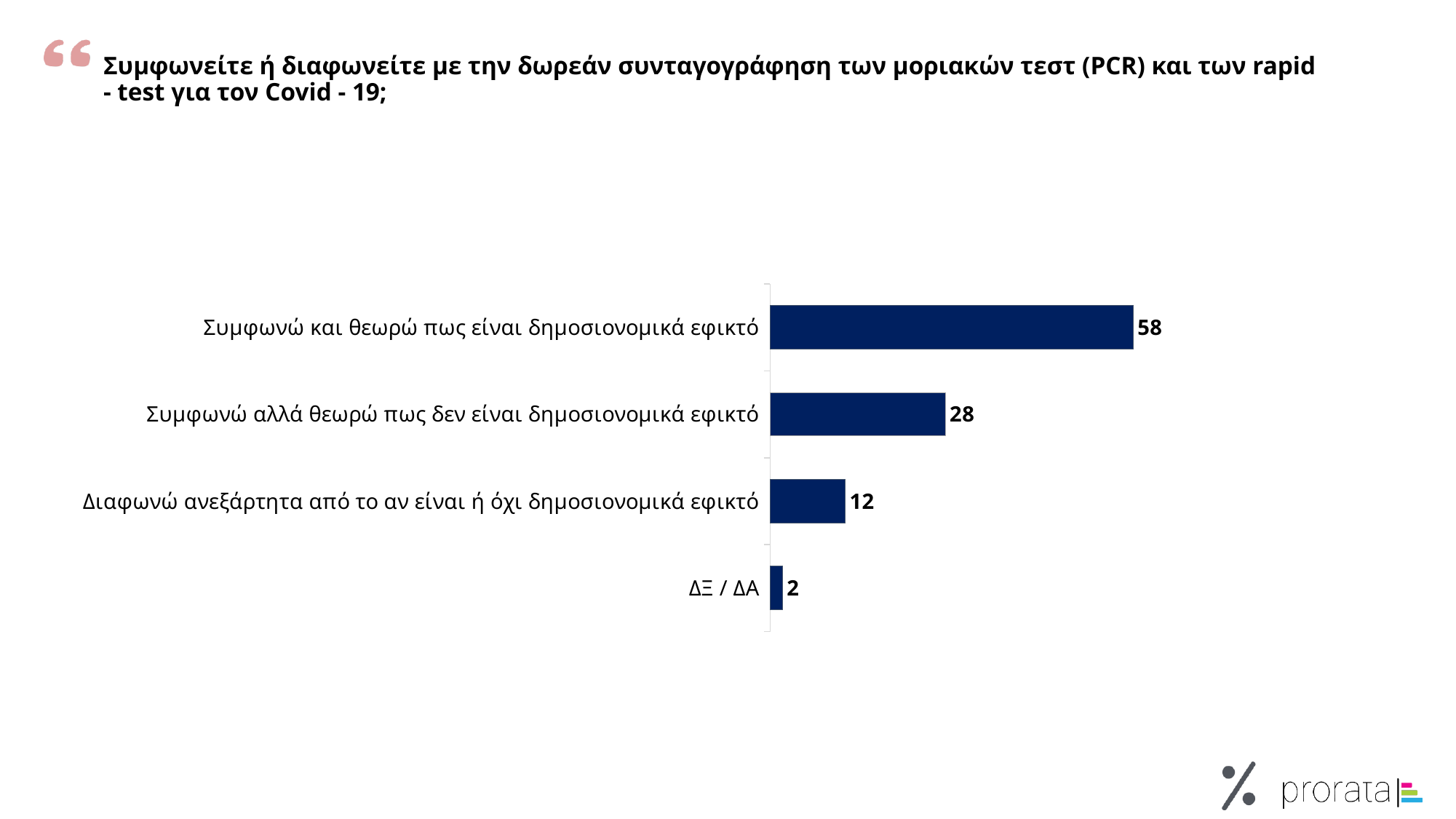
What is the difference between the values for 'Συμφωνώ και θεωρώ πως είναι δημοσιονομικά εφικτό' and 'Συμφωνώ αλλά θεωρώ πως δεν είναι δημοσιονομικά εφικτό'? 30 Which category has the lowest value? ΔΞ / ΔΑ Which is larger: the value for 'Συμφωνώ αλλά θεωρώ πως δεν είναι δημοσιονομικά εφικτό' or the value for 'Διαφωνώ ανεξάρτητα από το αν είναι ή όχι δημοσιονομικά εφικτό'? Συμφωνώ αλλά θεωρώ πως δεν είναι δημοσιονομικά εφικτό What is the value for 'Συμφωνώ αλλά θεωρώ πως δεν είναι δημοσιονομικά εφικτό'? 28 What is the difference between the values for 'Διαφωνώ ανεξάρτητα από το αν είναι ή όχι δημοσιονομικά εφικτό' and 'ΔΞ / ΔΑ'? 10 What is the value for 'Διαφωνώ ανεξάρτητα από το αν είναι ή όχι δημοσιονομικά εφικτό'? 12 What is the value for 'Συμφωνώ και θεωρώ πως είναι δημοσιονομικά εφικτό'? 58 How many categories are shown in the chart? 4 What is the value for 'ΔΞ / ΔΑ'? 2 Which category has the highest value? Συμφωνώ και θεωρώ πως είναι δημοσιονομικά εφικτό What colour are the bars in the chart? Dark navy blue What kind of chart is shown on the slide? Bar chart